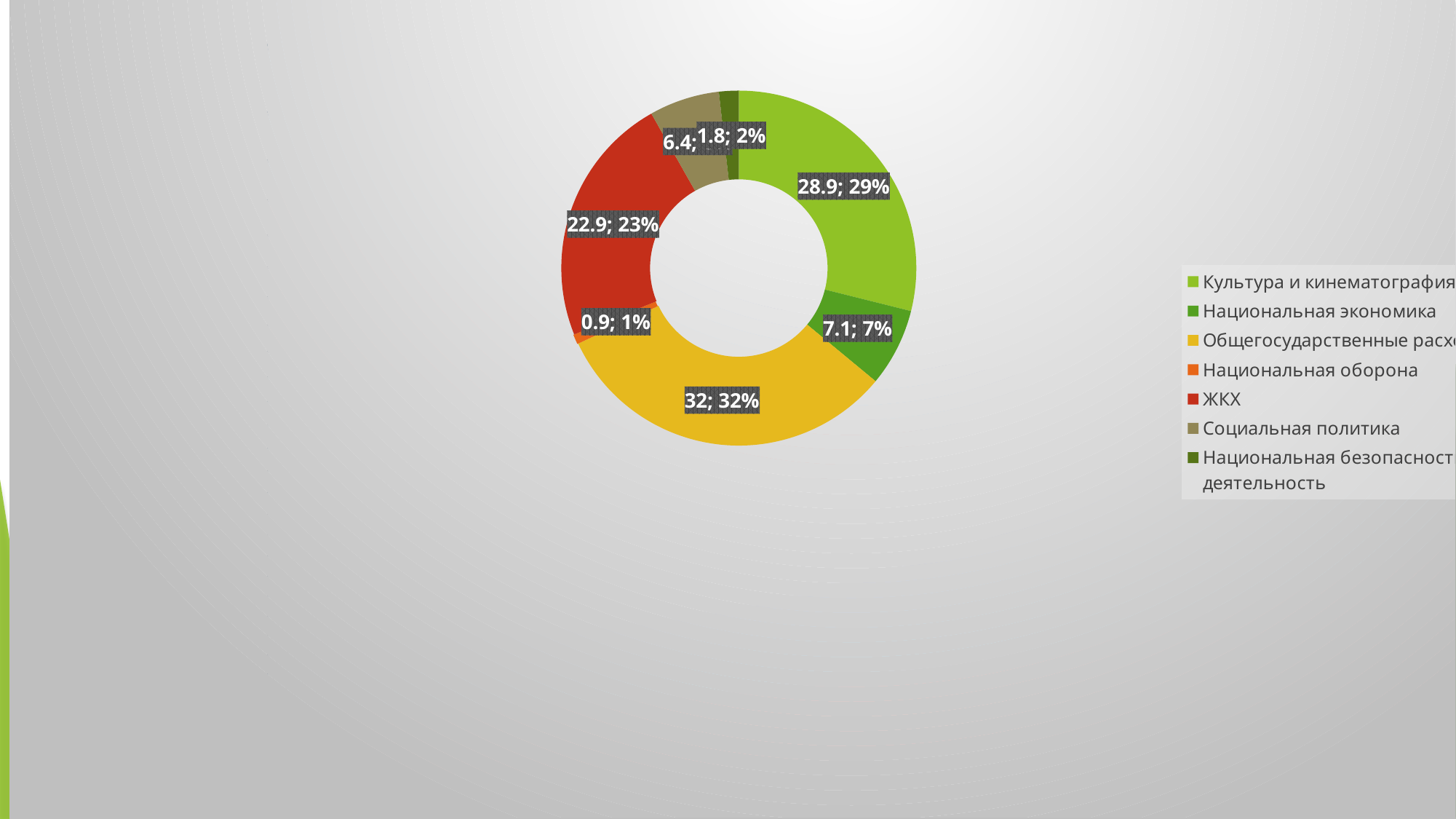
Which is larger, the value for ЖКХ or the value for Культура и кинематография? Культура и кинематография What is the value shown for Национальная экономика? 7.1 How many slices does the chart have? 7 What kind of chart is shown on the slide? doughnut chart What percentage share does ЖКХ have? 23% Which category has the smallest slice of the chart? Национальная оборона What is the value shown for Социальная политика? 6.4 What is the difference between the values for Культура и кинематография and ЖКХ? 6 What is the value shown for Национальная оборона? 0.9 What is the value shown for ЖКХ on the doughnut chart? 22.9 What is the difference between the values for ЖКХ and Национальная экономика? 15.8 What percentage share does Культура и кинематография have? 29%